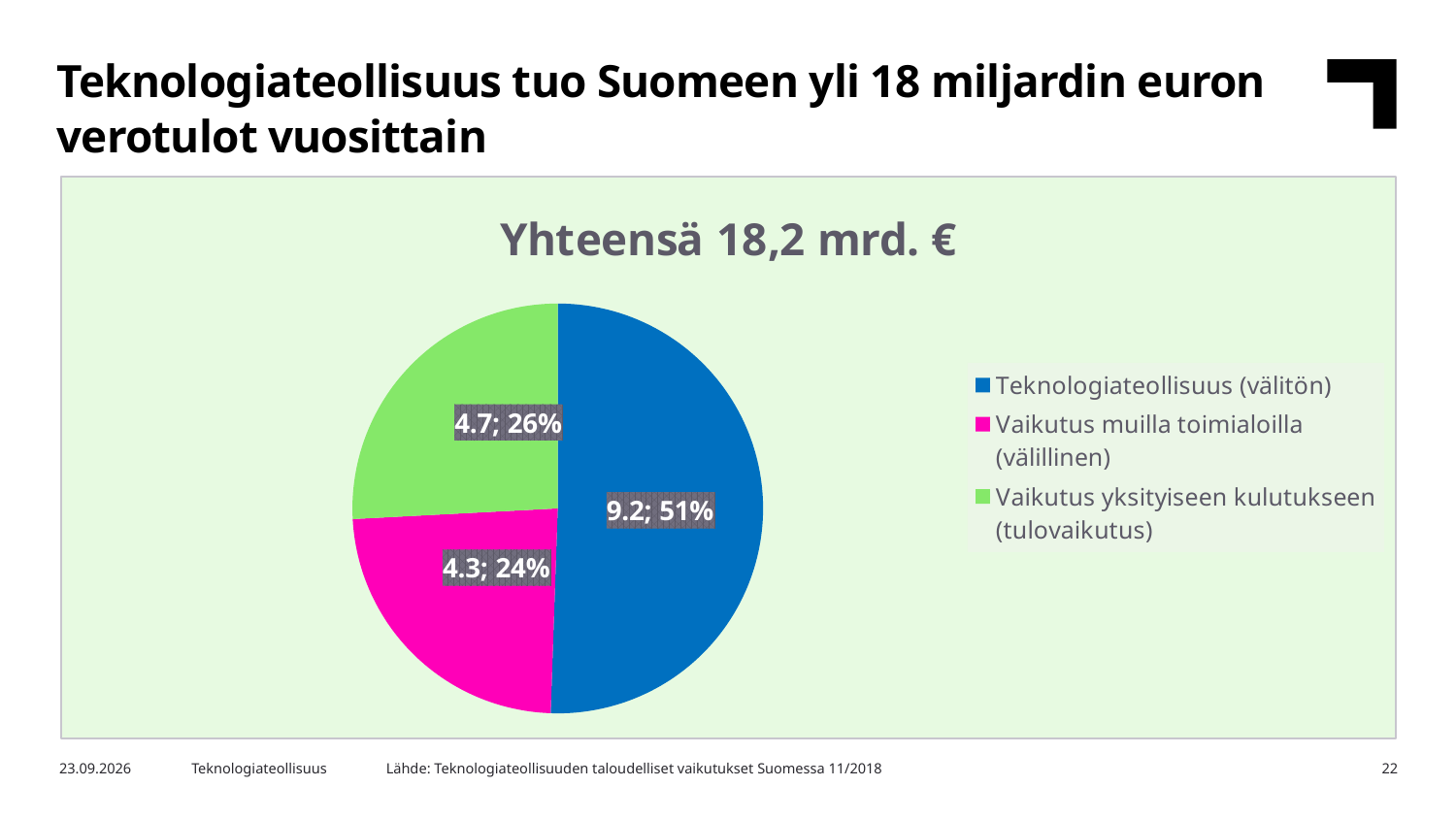
What is the chart's title? Yhteensä 18,2 mrd. € Which slice is the largest? Teknologiateollisuus (välitön) How many slices does the pie chart have? 3 Which slice is the smallest? Vaikutus muilla toimialoilla (välillinen) What value is shown for Teknologiateollisuus (välitön)? 9.2 What share of the pie does Vaikutus yksityiseen kulutukseen (tulovaikutus) represent? 26% What is the difference between the values for Teknologiateollisuus (välitön) and Vaikutus muilla toimialoilla (välillinen)? 4.9 What kind of chart is shown on the slide? pie chart How many entries does the legend list? 3 What value is shown for Vaikutus yksityiseen kulutukseen (tulovaikutus)? 4.7 What share of the pie does Teknologiateollisuus (välitön) represent? 51% What value is shown for Vaikutus muilla toimialoilla (välillinen)? 4.3